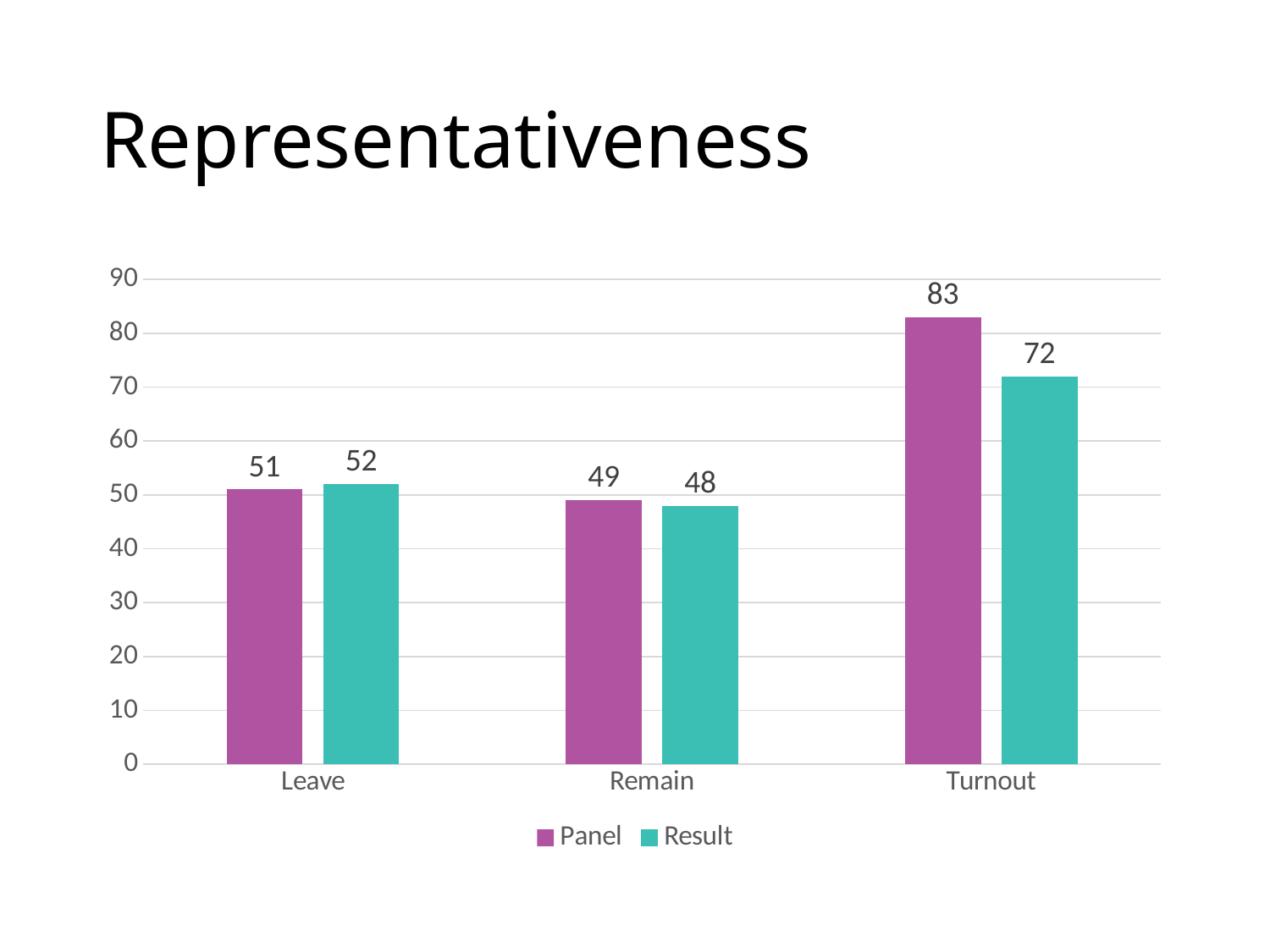
How many series does the legend list? 2 What kind of chart is shown on the slide? Bar chart What is the Result value for Leave? 52 Which is larger for Turnout, the Panel value or the Result value? Panel What is the Panel value for Turnout? 83 Which category has the lowest Result value? Remain What is the title of the slide? Representativeness What is the Panel value for Remain? 49 What is the Result value for Turnout? 72 Which category has the highest Panel value? Turnout How many categories are shown on the x axis? 3 What is the difference between the Panel and Result values for Turnout? 11